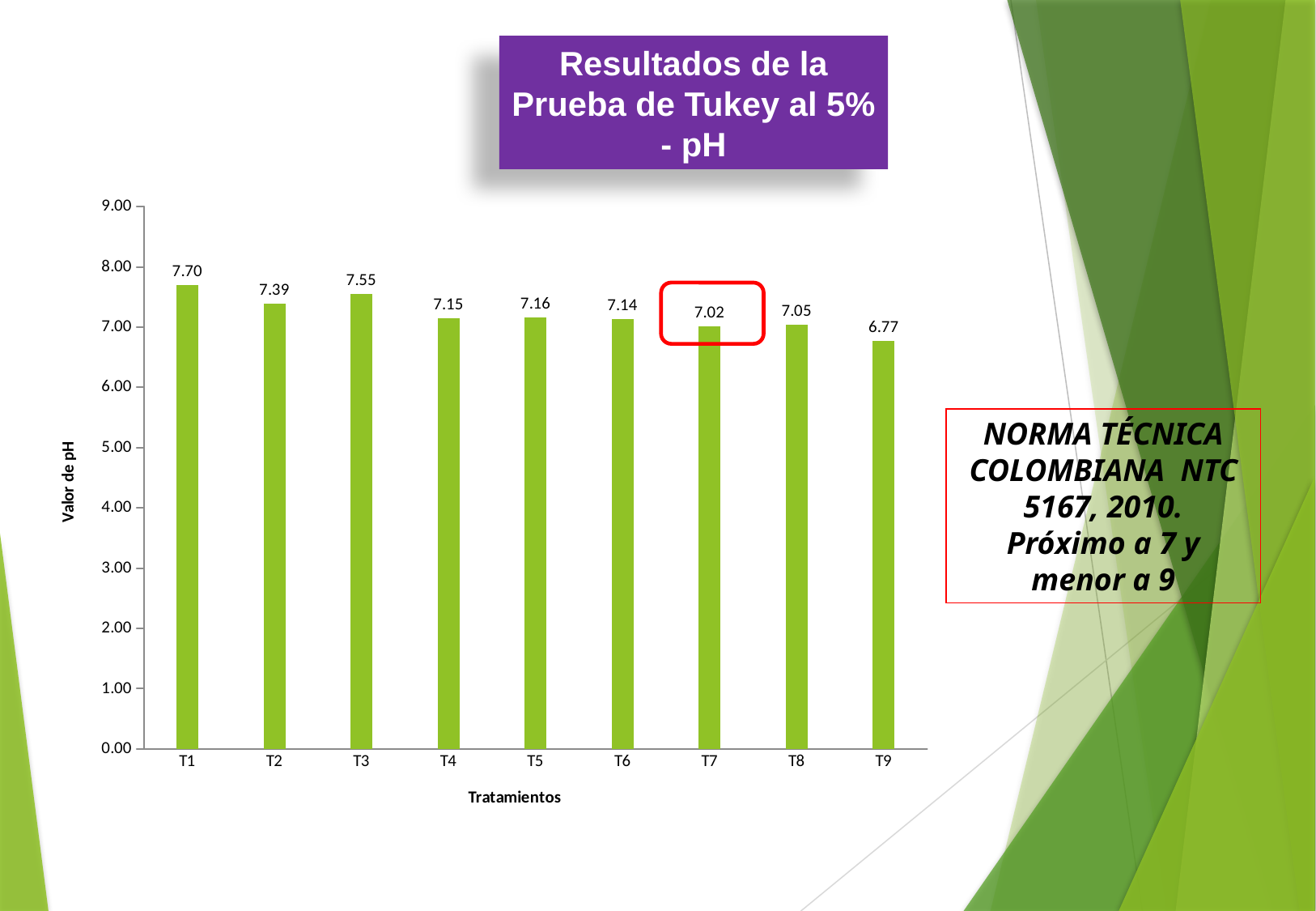
What is the label of the x axis? Tratamientos Which treatment has the highest pH value? T1 Which treatment has the lowest pH value? T9 What is the pH value for T7? 7.02 What kind of chart is shown on the slide? Bar chart What is the label of the y axis? Valor de pH Is the value for T9 greater or less than 7.00? less What is the pH value for T1? 7.70 Which has a higher pH value, T2 or T3? T3 What is the difference between the pH values of T1 and T9? 0.93 What is the pH value for T9? 6.77 How many treatments are shown on the x axis? 9